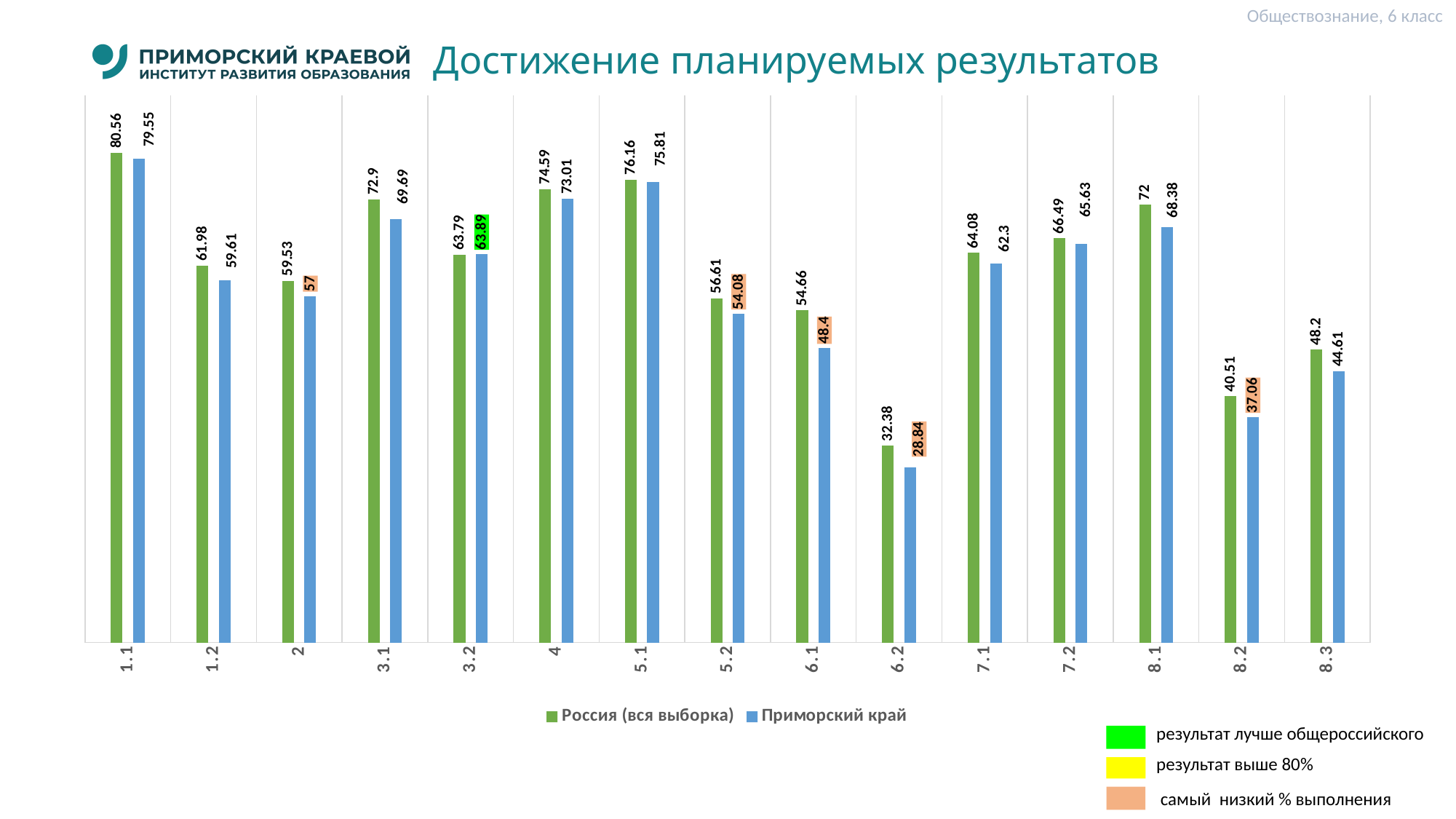
What is the value for Приморский край for category 8.2? 37.06 How many series does the legend list? 2 For category 3.2, which series has the larger value: Россия (вся выборка) or Приморский край? Приморский край Which category has the lowest value for Россия (вся выборка)? 6.2 What colour are the bars for Приморский край? Blue Which category has the highest value for Приморский край? 1.1 What kind of chart is shown on the slide? Bar chart What is the difference between the Россия (вся выборка) and Приморский край values for category 6.1? 6.26 What is the difference between the Приморский край values for categories 1.1 and 6.2? 50.71 What is the value for Приморский край for category 6.1? 48.4 How many categories are shown on the x axis? 15 What is the value for Россия (вся выборка) for category 3.2? 63.79